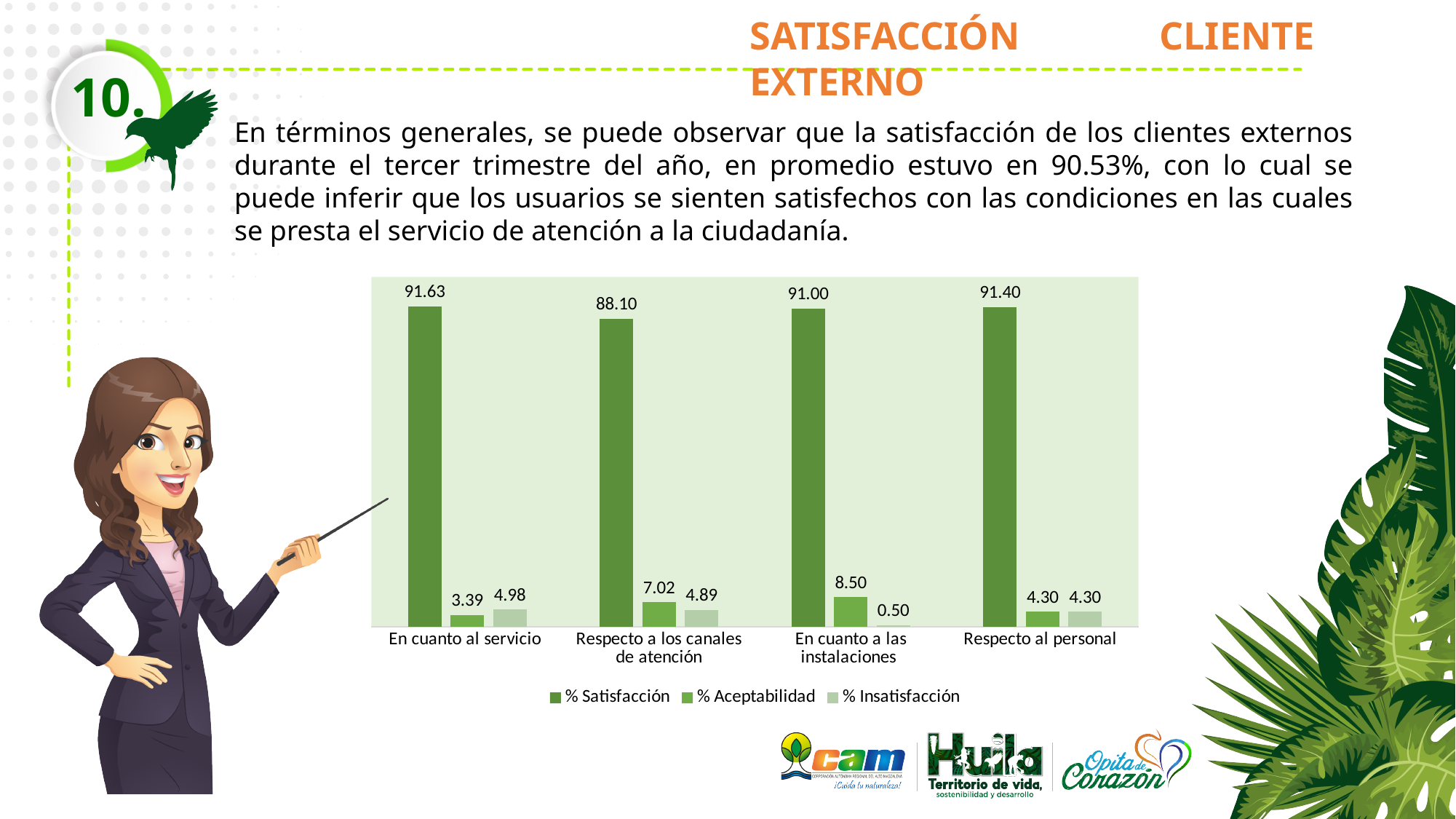
Which category has the highest % Satisfacción value? En cuanto al servicio Which category has the lowest % Satisfacción value? Respecto a los canales de atención How many categories are shown on the x axis of the chart? 4 What kind of chart is shown on the slide? Bar chart What is the % Aceptabilidad value for "Respecto al personal"? 4.30 Which is larger: the % Insatisfacción value for "En cuanto al servicio" or for "Respecto al personal"? En cuanto al servicio What is the % Insatisfacción value for "En cuanto a las instalaciones"? 0.50 What is the % Aceptabilidad value for "Respecto a los canales de atención"? 7.02 What is the % Satisfacción value for "En cuanto al servicio"? 91.63 What is the difference between the % Satisfacción values for "En cuanto al servicio" and "Respecto a los canales de atención"? 3.53 How many series does the chart's legend list? 3 Which category has the highest % Aceptabilidad value? En cuanto a las instalaciones